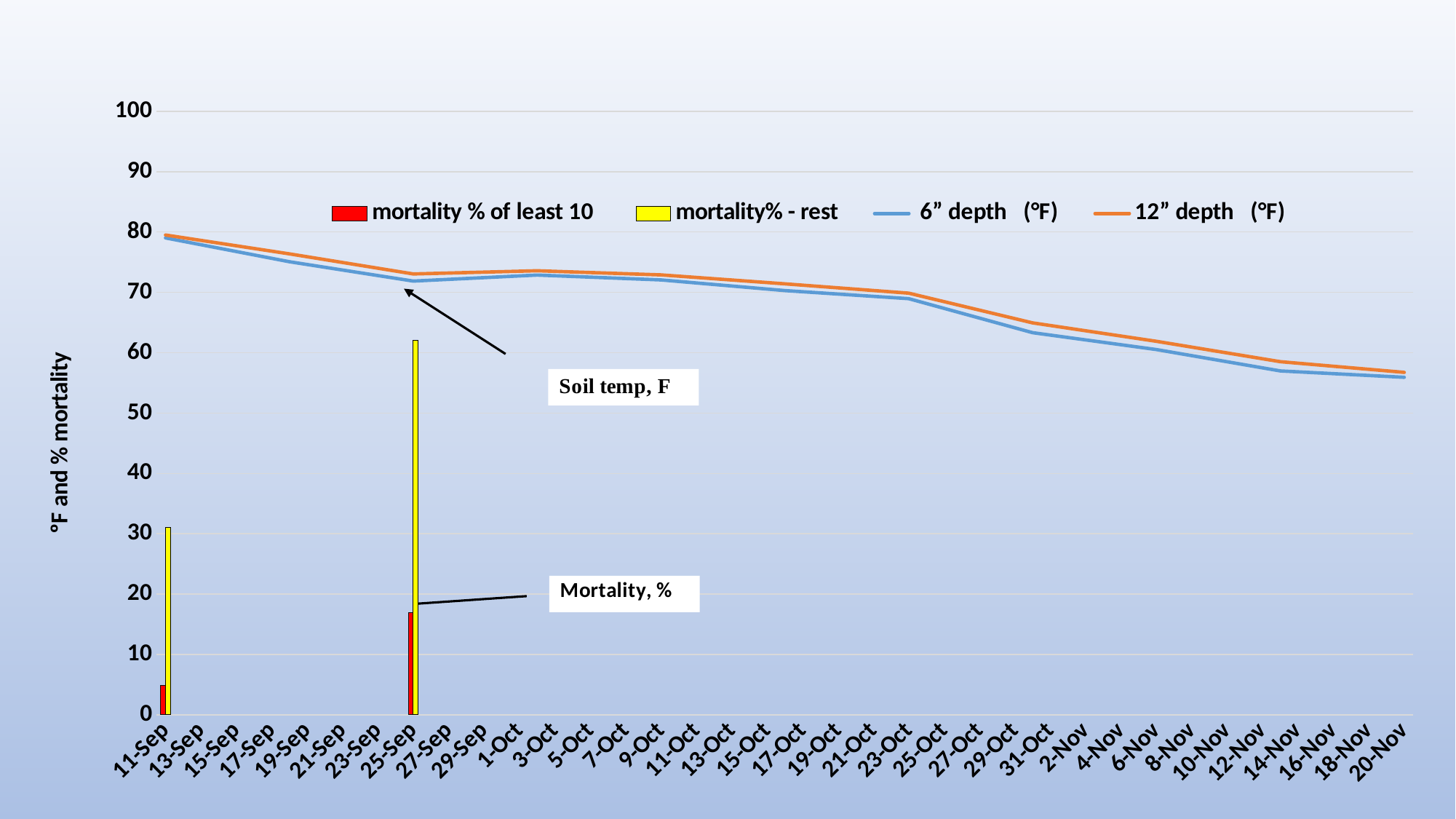
What kind of chart is this? A combined bar and line chart Is the value of the "mortality % of least 10" bar on 25-Sep greater or less than 20? less On 20-Nov, which line is higher, 6" depth (°F) or 12" depth (°F)? 12" depth (°F) Is the value of the "mortality % of least 10" bar on 11-Sep greater or less than 10? less What colour represents the "mortality % of least 10" series in the legend? Red Which date has the taller "mortality% - rest" bar, 11-Sep or 25-Sep? 25-Sep Do the soil temperature lines generally rise or fall from 11-Sep to 20-Nov? fall How many series does the legend list? 4 What is the title of the vertical axis? °F and % mortality Is the 6" depth (°F) value on 20-Nov greater or less than 60? less